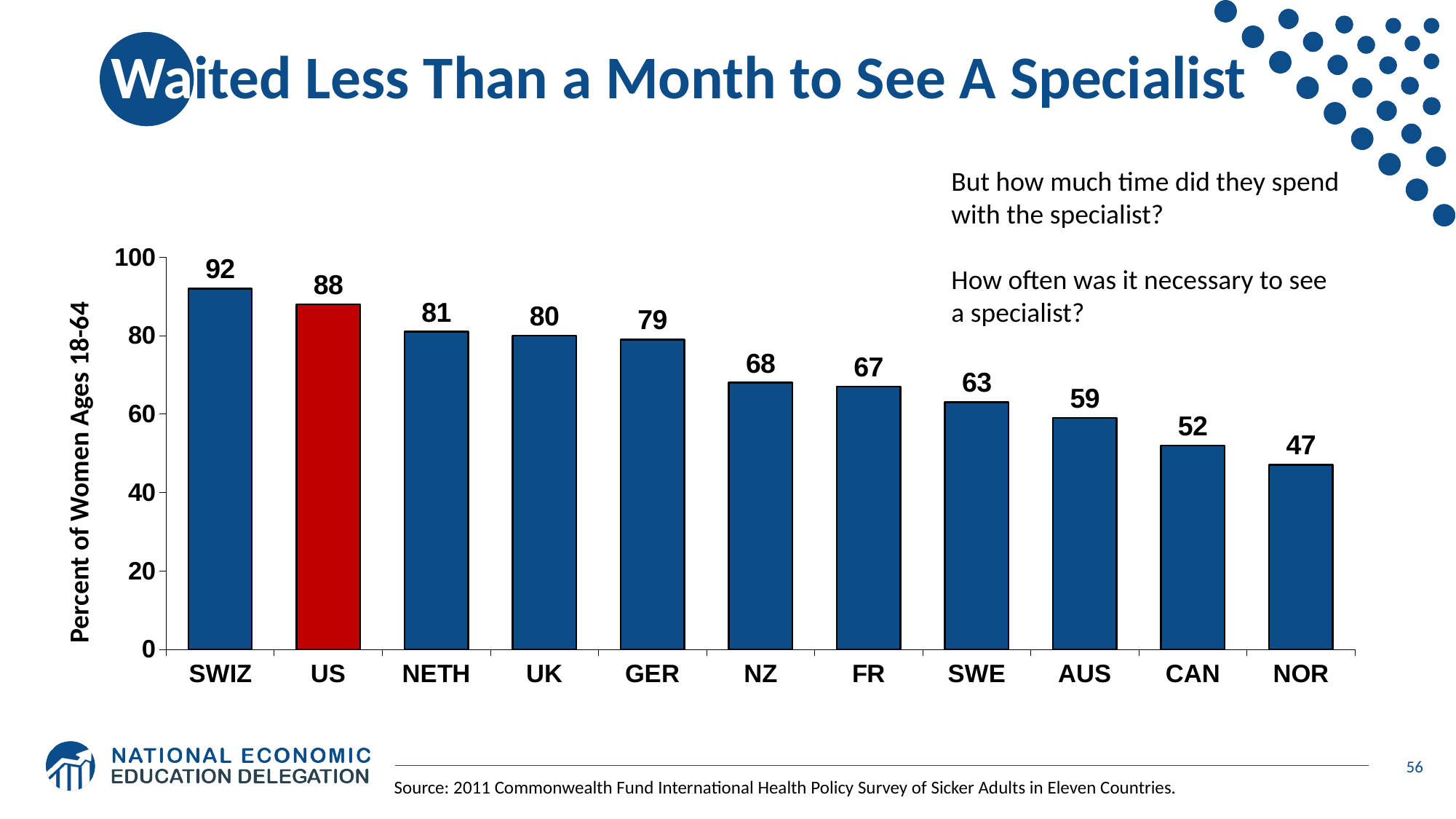
Which country's bar is coloured red? US What is the difference between the values for CAN and NOR? 5 Is the value for AUS greater or less than 60? less What is the difference between the values for SWIZ and the US? 4 How many countries are shown on the chart? 11 What kind of chart is shown on the slide? bar chart Which country has the highest value? SWIZ What is the value for GER? 79 What is the value for the US? 88 Which country has the lowest value? NOR What is the value for NOR? 47 Which is larger, the value for NZ or the value for SWE? NZ